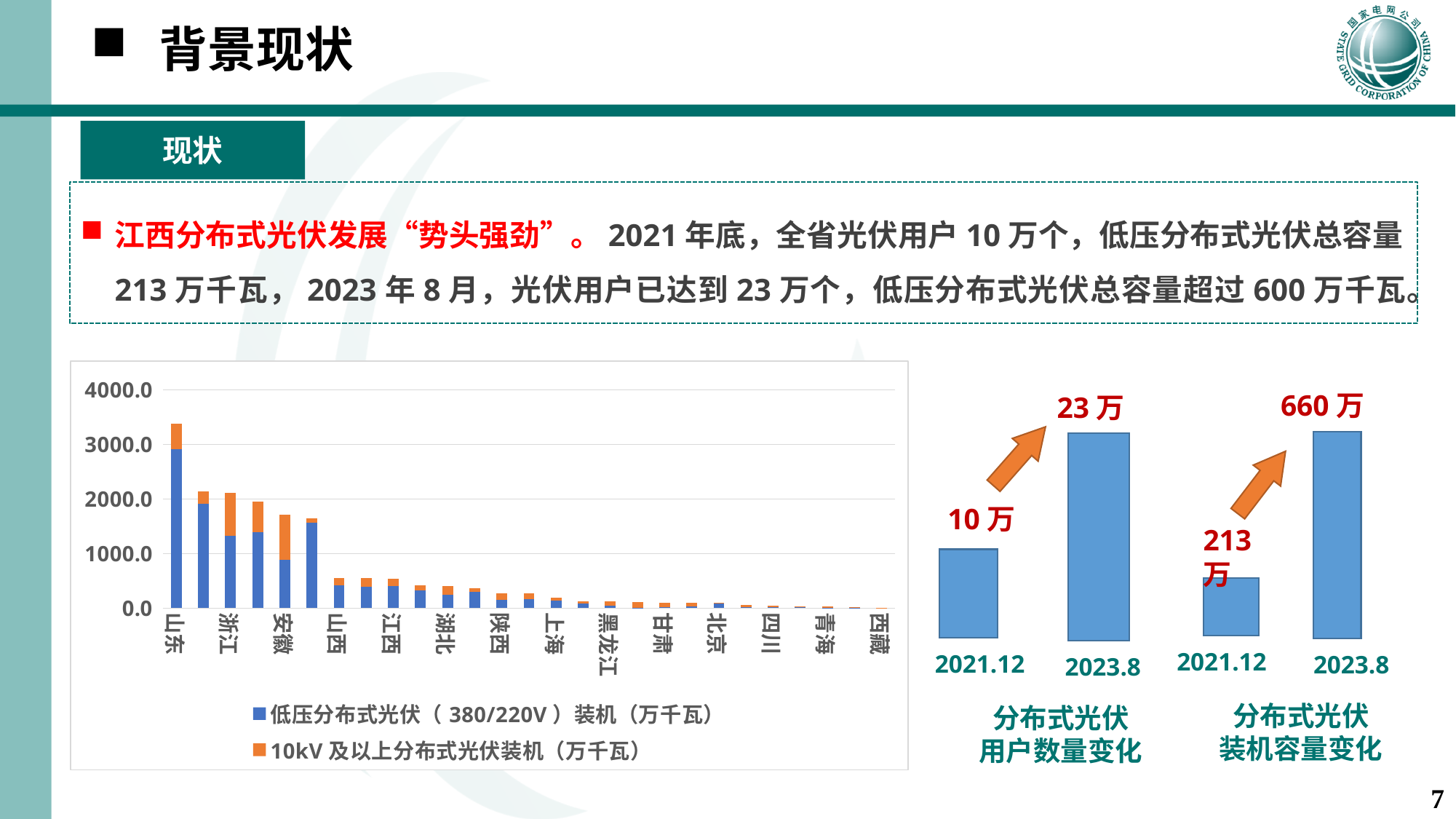
In the left chart, which colour represents 10kV及以上分布式光伏装机（万千瓦）? Orange In the left chart, is the total stacked value for 山东 greater or less than 3000? greater In the chart titled 分布式光伏装机容量变化, what is the value for 2023.8? 660万 In the chart titled 分布式光伏用户数量变化, do the values rise or fall from 2021.12 to 2023.8? Rise In the left chart, which province has the tallest stacked bar? 山东 In the left chart, is the total stacked value for 安徽 greater or less than 2000? less What kind of chart is the large chart on the left of the slide? Stacked bar chart How many series does the legend of the left chart list? 2 In the chart titled 分布式光伏装机容量变化, what is the difference between the 2023.8 value and the 2021.12 value? 447万 In the chart titled 分布式光伏用户数量变化, what is the value for 2021.12? 10万 In the chart titled 分布式光伏用户数量变化, what is the value for 2023.8? 23万 In the left chart, is the total stacked value for 山西 greater or less than 1000? less